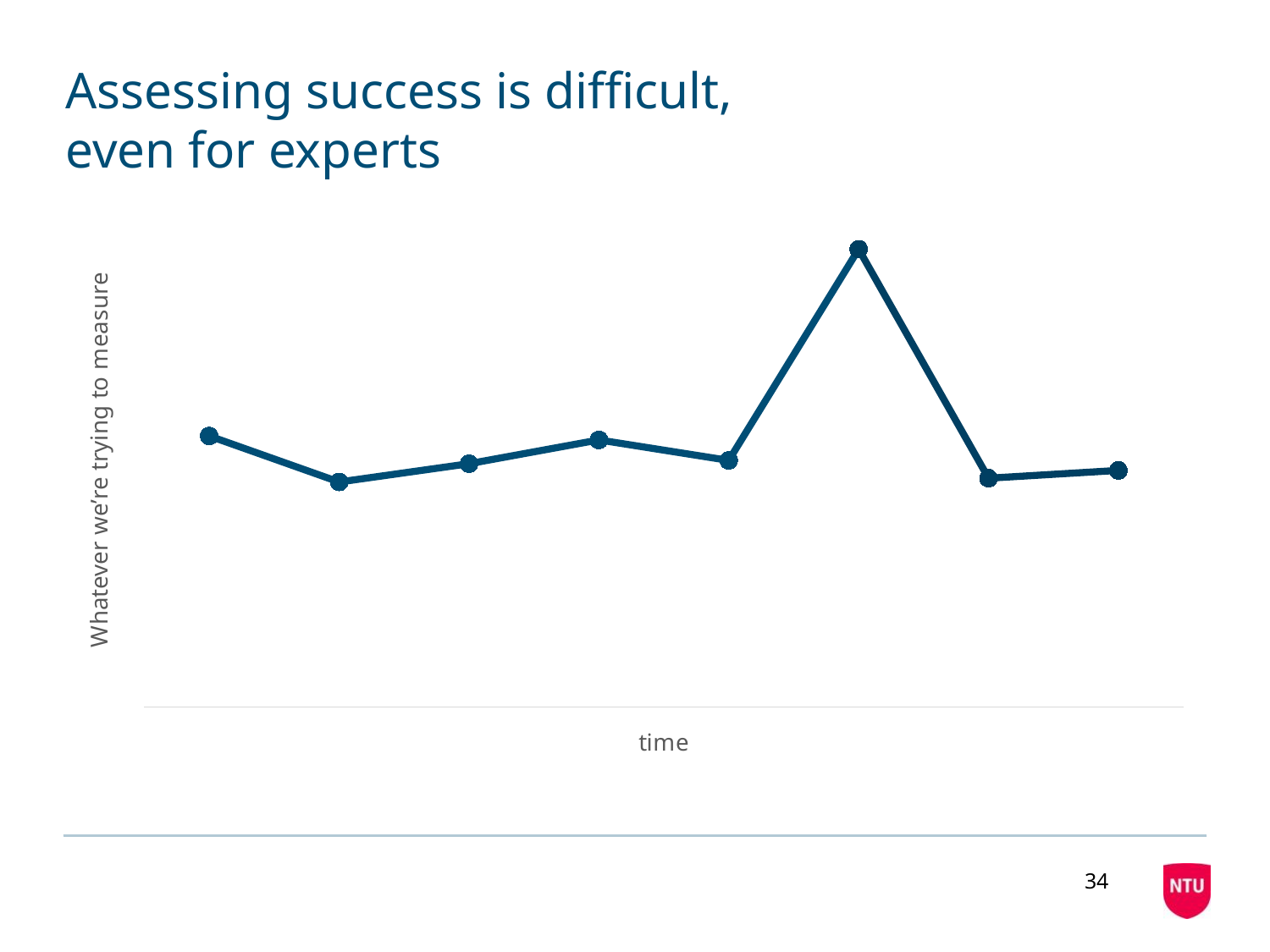
What kind of chart is shown on the slide? line chart How many data points are plotted on the line? 8 How many lines (series) are plotted on the chart? 1 Does the line rise or fall between the sixth and seventh points from the left? fall What is the label on the horizontal axis? time Is the first point or the second point from the left higher? the first point Which data point, counting from the left, has the highest value? the 6th point What is the label on the vertical axis? Whatever we're trying to measure Does the line rise or fall between the fifth and sixth points from the left? rise Is the sixth point or the seventh point from the left higher? the sixth point Does the line rise or fall between the first and second points from the left? fall